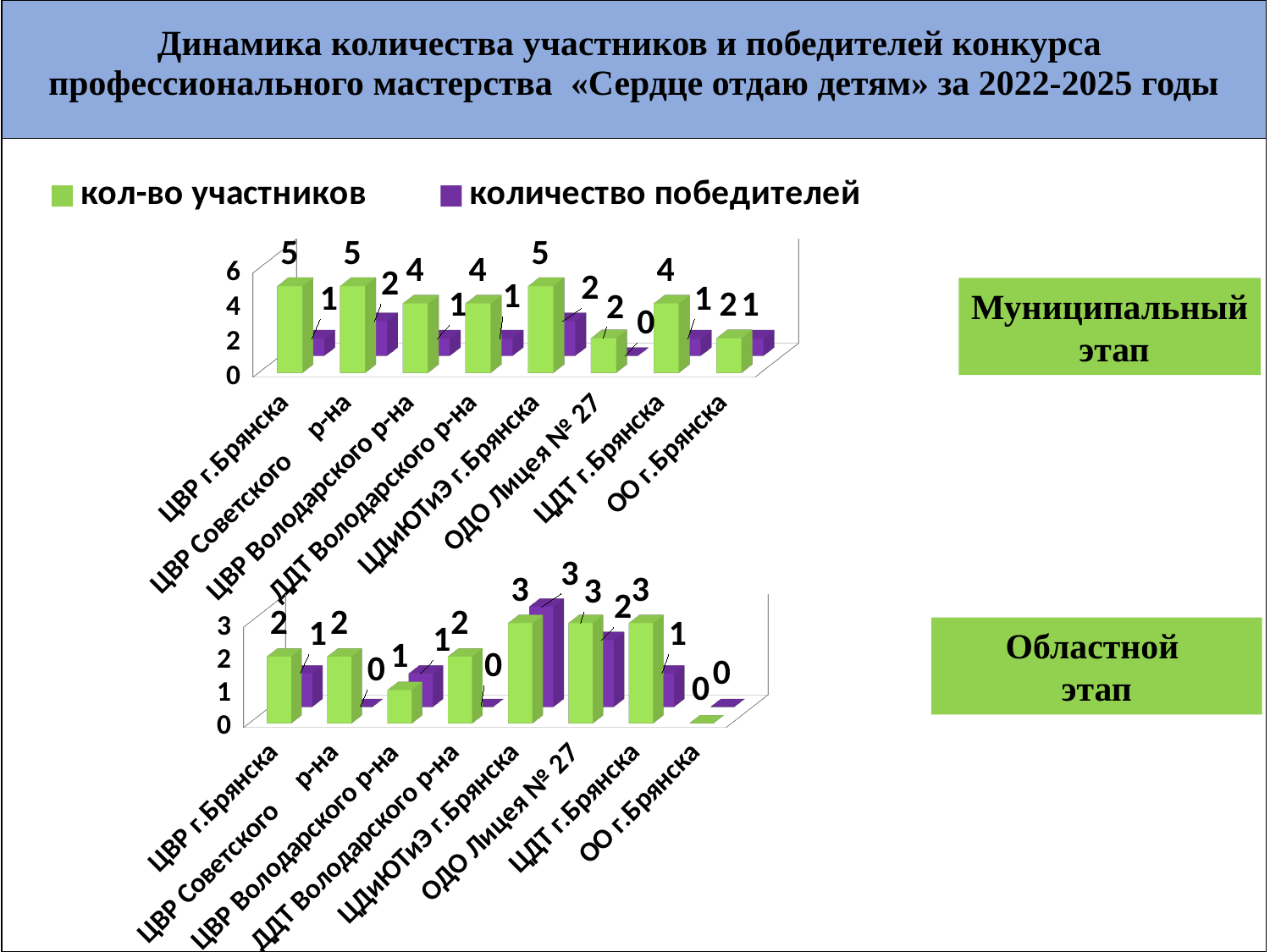
On the Областной этап chart, what is the difference between кол-во участников and количество победителей for ЦДТ г.Брянска? 2 On the Областной этап chart, what is the кол-во участников for ОО г.Брянска? 0 On the Муниципальный этап chart, what is the кол-во участников for ЦВР Володарского р-на? 4 How many categories are shown on the Областной этап chart? 8 On the Муниципальный этап chart, which has the lower кол-во участников, ОДО Лицея № 27 or ЦДТ г.Брянска? ОДО Лицея № 27 On the Муниципальный этап chart, what is the количество победителей for ОДО Лицея № 27? 0 On the Областной этап chart, what is the количество победителей for ЦДиЮТиЭ г.Брянска? 3 How many series does the legend list? 2 What type of chart is the Муниципальный этап chart? Bar chart On the Муниципальный этап chart, what is the количество победителей for ЦВР Советского р-на? 2 On the Областной этап chart, what is the кол-во участников for ЦВР Володарского р-на? 1 On the Муниципальный этап chart, what is the difference between кол-во участников and количество победителей for ЦВР г.Брянска? 4